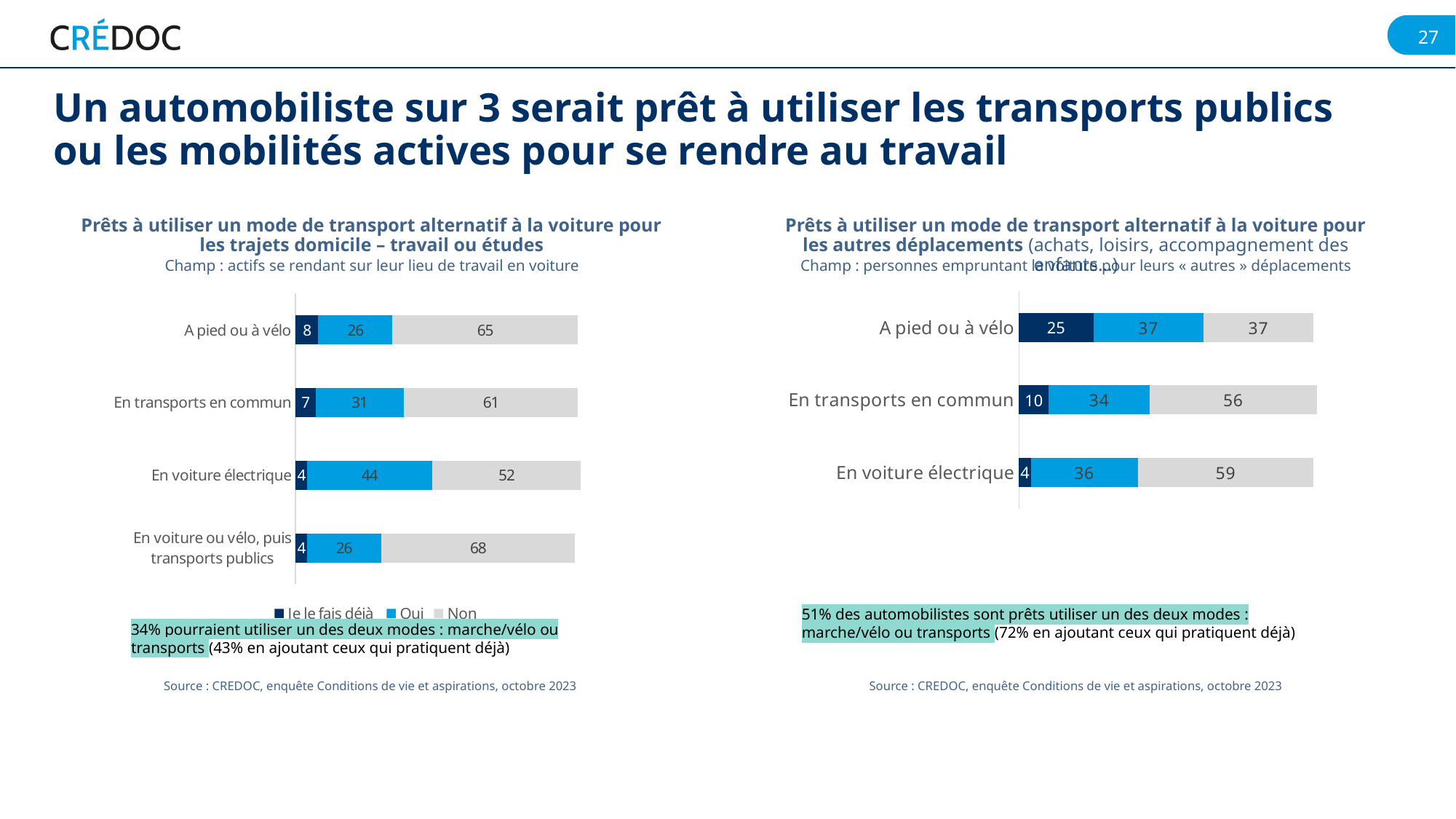
In the right chart (autres déplacements), what is the dark blue (already doing it) value for 'A pied ou à vélo'? 25 How many categories does the left chart (trajets domicile – travail ou études) show? 4 How many series does the legend of the left chart (trajets domicile – travail ou études) list? 3 In the left chart (trajets domicile – travail ou études), what is the difference between the 'Non' values for 'En voiture ou vélo, puis transports publics' and 'En voiture électrique'? 16 In the right chart (autres déplacements), what is the 'Non' value for 'En transports en commun'? 56 In the left chart (trajets domicile – travail ou études), what is the 'Je le fais déjà' value for 'A pied ou à vélo'? 8 In the left chart (trajets domicile – travail ou études), what is the 'Oui' value for 'En voiture électrique'? 44 What type of chart is the right chart (autres déplacements)? Stacked bar chart In the left chart (trajets domicile – travail ou études), which category has the highest 'Oui' value? En voiture électrique In the left chart (trajets domicile – travail ou études), what is the 'Non' value for 'En voiture ou vélo, puis transports publics'? 68 In the right chart (autres déplacements), is the 'Oui' value larger for 'A pied ou à vélo' or for 'En transports en commun'? A pied ou à vélo In the right chart (autres déplacements), which category has the lowest 'Non' value? A pied ou à vélo